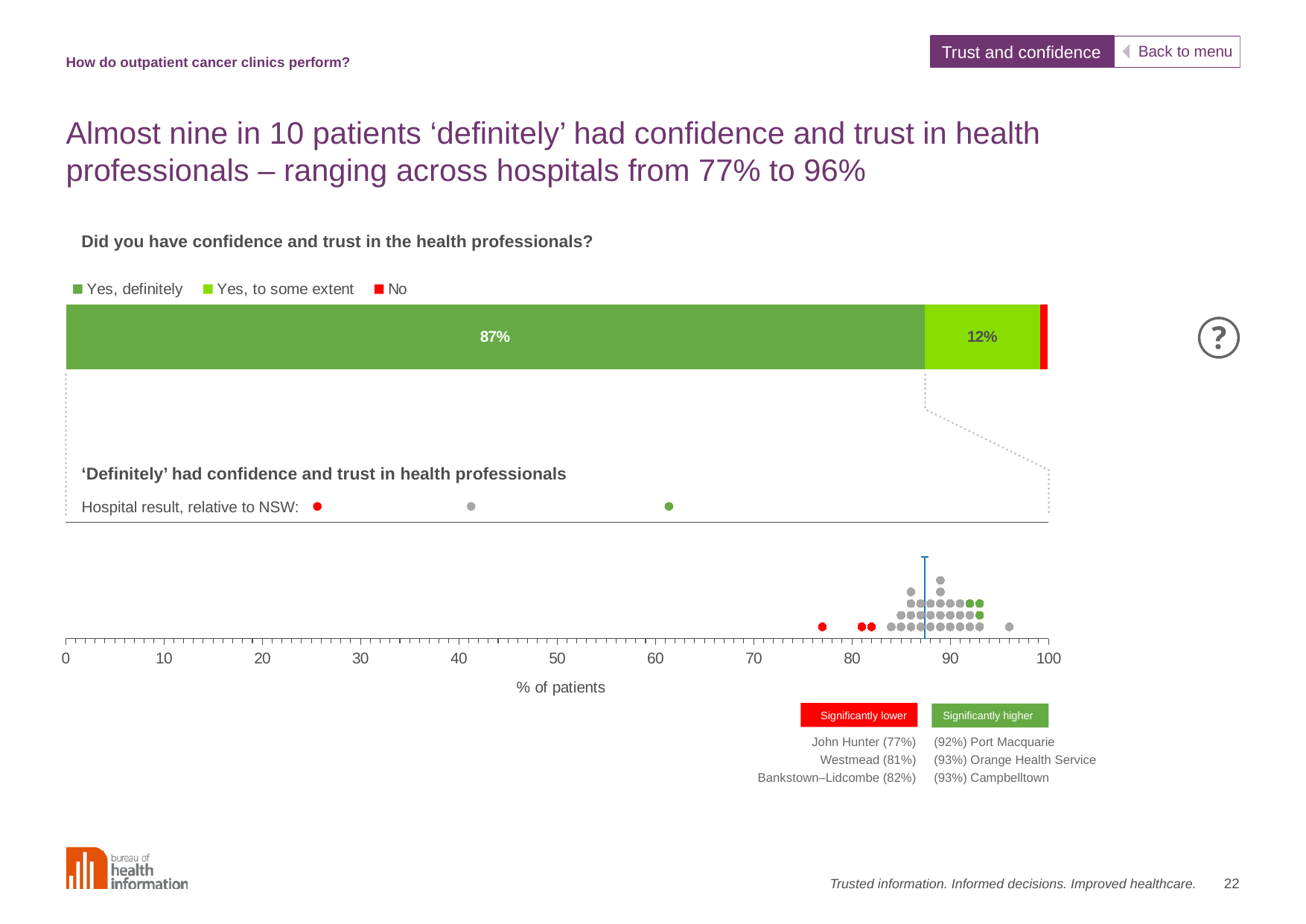
In the hospital dot plot, what is the result for Port Macquarie? 92% How many response categories does the legend of the stacked bar chart list? 3 What question is the stacked bar chart titled with? Did you have confidence and trust in the health professionals? In the hospital dot plot, which named hospital has the lowest result? John Hunter In the hospital dot plot, what percentage of John Hunter patients 'definitely' had confidence and trust in health professionals? 77% In the hospital dot plot, what is the difference in percentage points between Campbelltown and Westmead? 12 percentage points In the hospital dot plot, how many hospitals are listed as significantly lower than NSW? 3 In the stacked bar chart, what is the difference in percentage points between 'Yes, definitely' and 'Yes, to some extent'? 75 percentage points In the stacked bar chart, what percentage of patients answered 'Yes, definitely'? 87% In the stacked bar chart, which response has the larger share: 'Yes, definitely' or 'Yes, to some extent'? Yes, definitely What kind of chart shows the breakdown of responses to 'Did you have confidence and trust in the health professionals?' Stacked bar chart In the stacked bar chart, what percentage of patients answered 'Yes, to some extent'? 12%